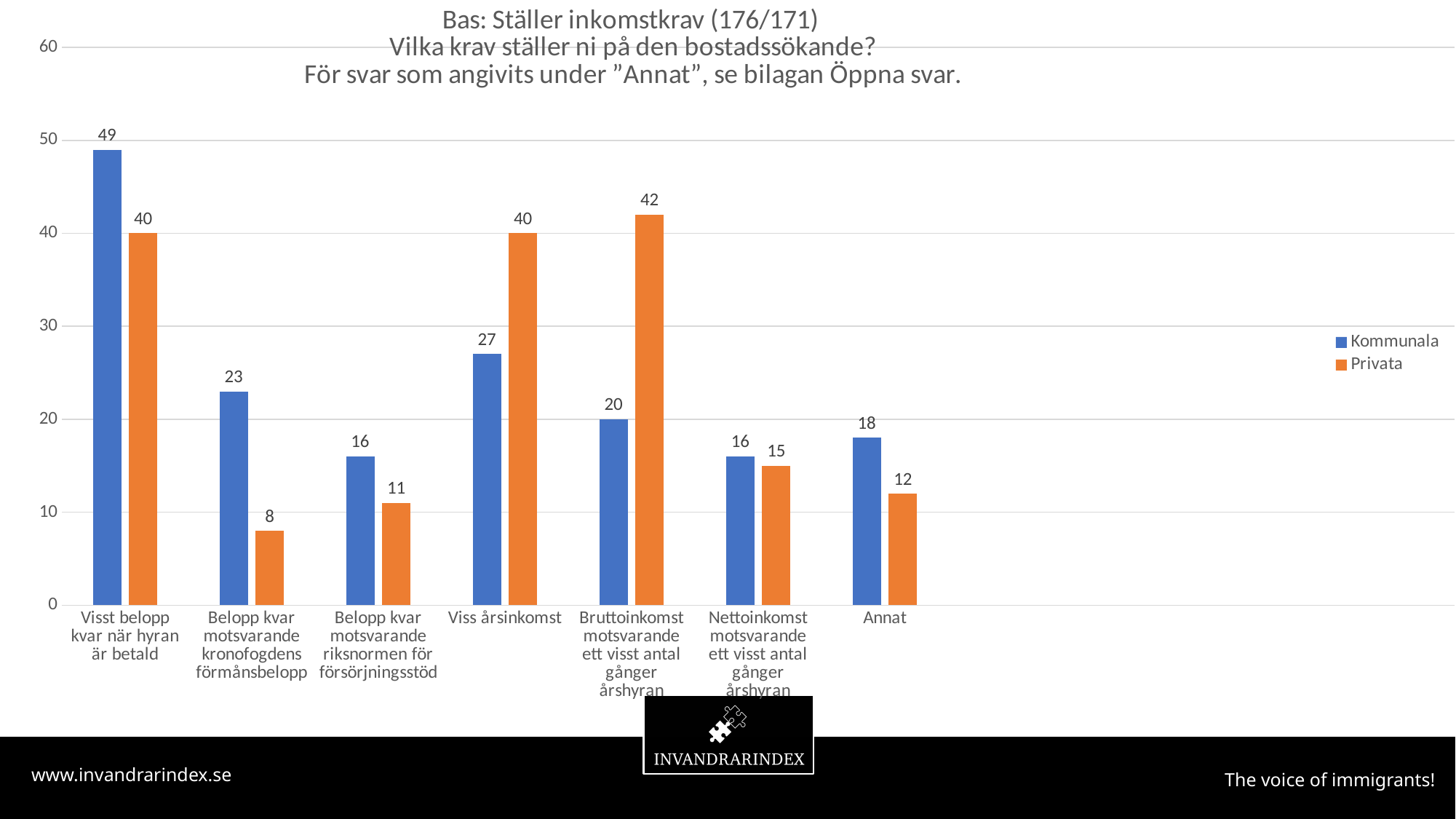
What is the Privata value for "Belopp kvar motsvarande kronofogdens förmånsbelopp"? 8 Which category has the highest Kommunala value? Visst belopp kvar när hyran är betald What kind of chart is shown on the slide? Bar chart Which category has the lowest Privata value? Belopp kvar motsvarande kronofogdens förmånsbelopp How many series does the legend list? 2 What is the Privata value for "Bruttoinkomst motsvarande ett visst antal gånger årshyran"? 42 How many categories are shown on the x axis? 7 For "Annat", which series has the larger value, Kommunala or Privata? Kommunala What is the difference between the Privata and Kommunala values for "Viss årsinkomst"? 13 Which colour represents the Privata series? Orange What is the Kommunala value for "Visst belopp kvar när hyran är betald"? 49 Is the Kommunala value for "Bruttoinkomst motsvarande ett visst antal gånger årshyran" greater or less than 30? less